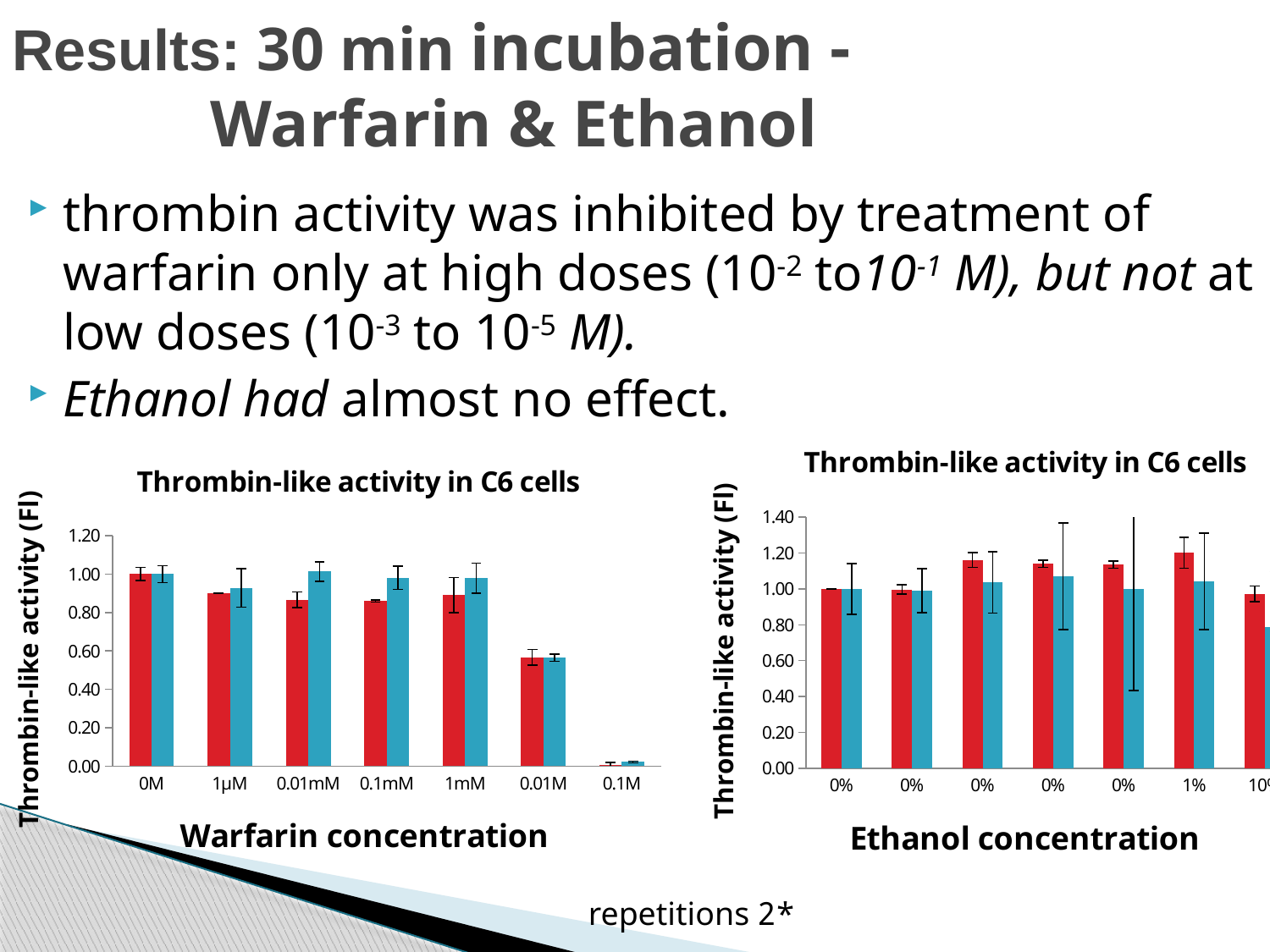
What is the y-axis title of the right chart (Ethanol concentration)? Thrombin-like activity (FI) What type of chart is the left chart with the x-axis 'Warfarin concentration'? bar chart In the left chart (Warfarin concentration), is the red bar for 0M greater or less than 0.80? greater In the right chart (Ethanol concentration), is the red bar for 1% greater or less than 1.00? greater In the left chart (Warfarin concentration), is the red bar for 0.01M greater or less than 0.80? less In the left chart (Warfarin concentration), which has the larger red bar, 0M or 0.01M? 0M What is the title of the left chart? Thrombin-like activity in C6 cells In the left chart (Warfarin concentration), do the bar values generally rise or fall moving from 0M to 0.1M along the x axis? fall How many warfarin concentration categories are shown on the x axis of the left chart? 7 In the left chart (Warfarin concentration), which concentration has the lowest thrombin-like activity? 0.1M